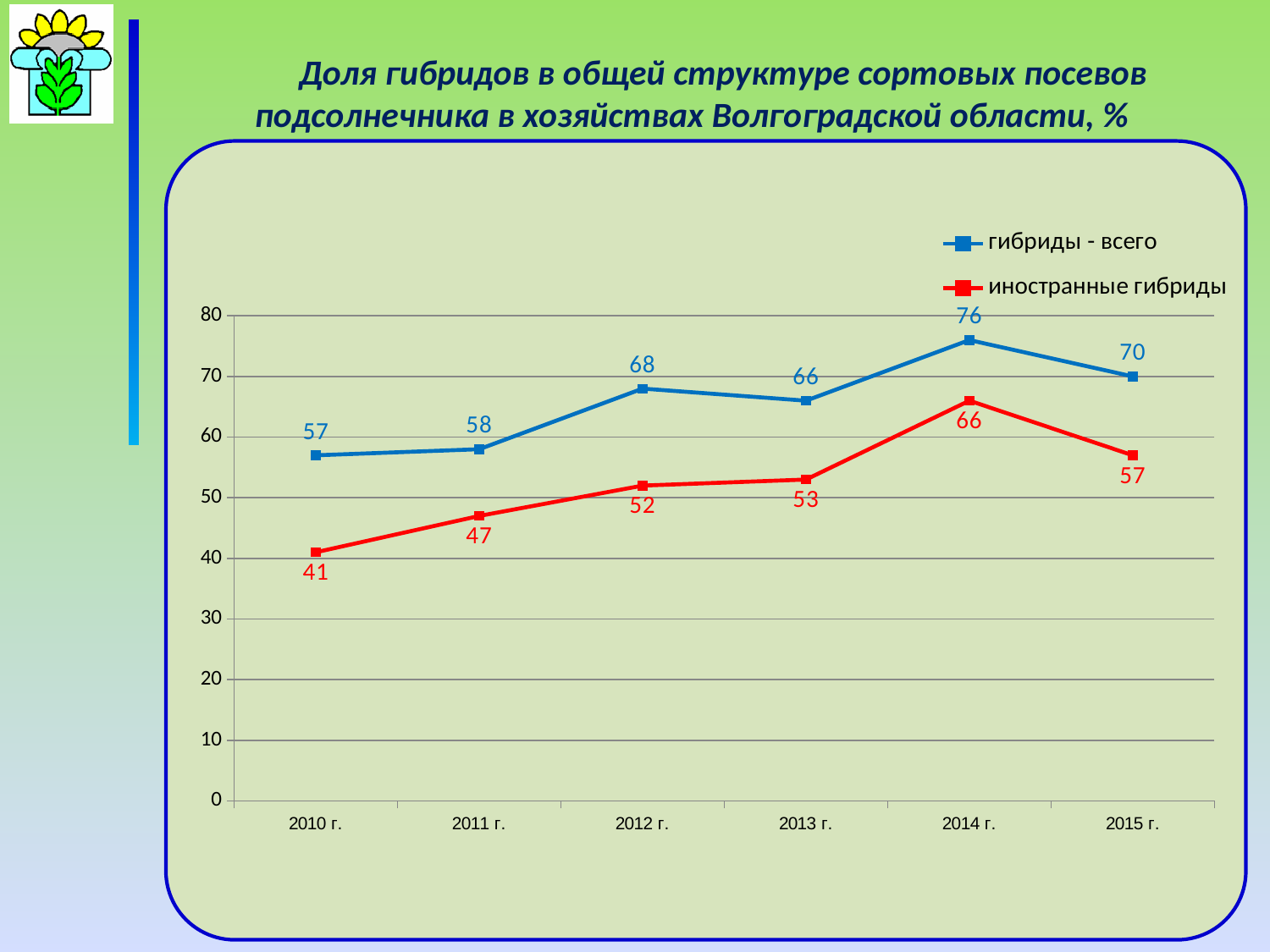
How many series does the legend list? 2 What kind of chart is shown on the slide? line chart In which year is the "иностранные гибриды" series lowest? 2010 г. Which is larger: "иностранные гибриды" in 2014 г. or "гибриды - всего" in 2010 г.? иностранные гибриды in 2014 г. What is the value for "гибриды - всего" in 2012 г.? 68 What is the difference between the "гибриды - всего" values for 2014 г. and 2015 г.? 6 In which year is the "гибриды - всего" series highest? 2014 г. How many years are shown on the x axis? 6 Does the "иностранные гибриды" series rise or fall from 2010 г. to 2014 г.? rise What is the value for "иностранные гибриды" in 2015 г.? 57 What is the difference between "гибриды - всего" and "иностранные гибриды" in 2010 г.? 16 What is the value for "иностранные гибриды" in 2010 г.? 41